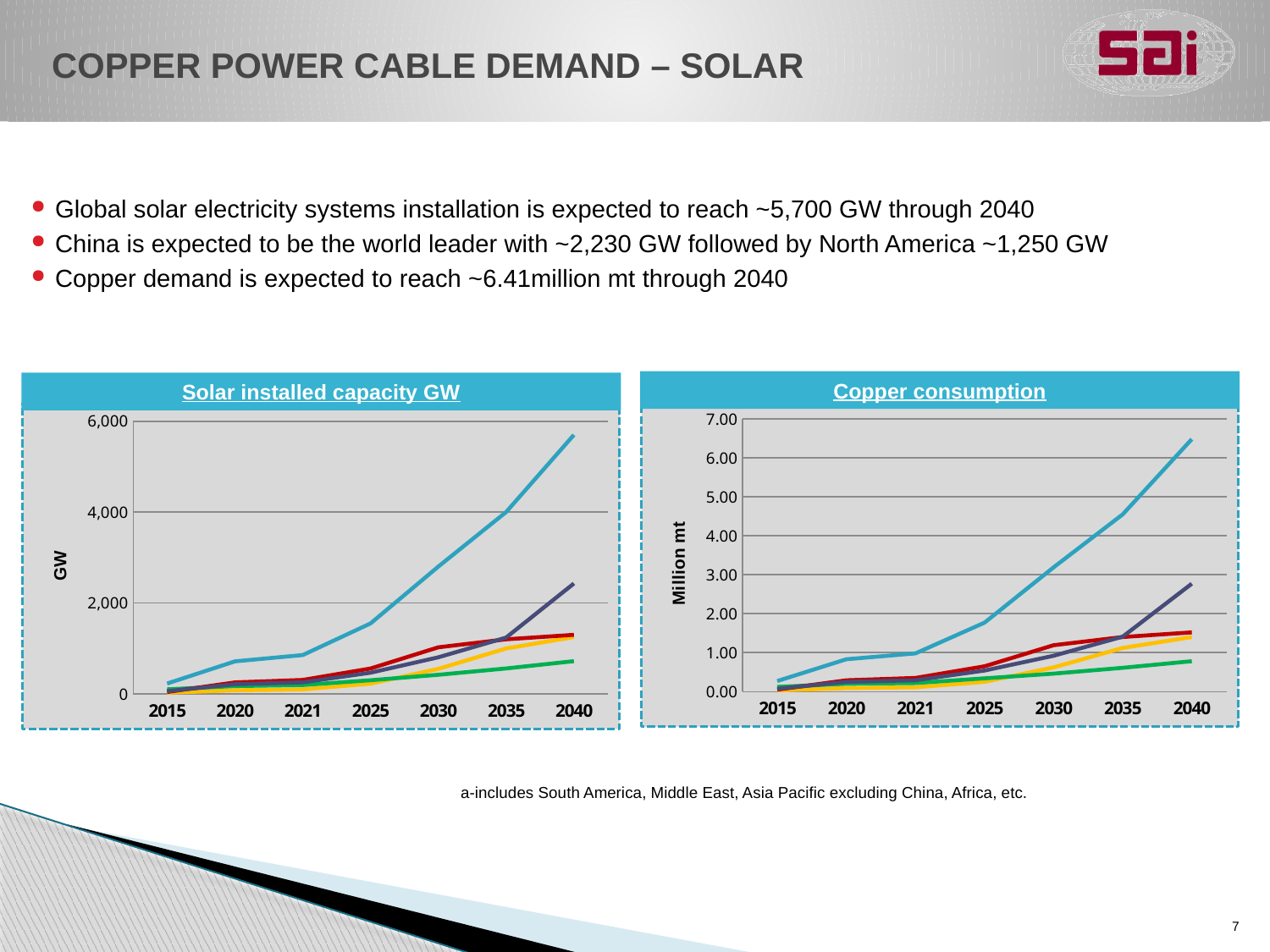
In the 'Solar installed capacity GW' chart, is the value of the highest line in 2040 greater or less than 4,000? greater What is the y-axis label of the 'Copper consumption' chart? Million mt In the 'Solar installed capacity GW' chart, does the highest line rise or fall from 2015 to 2040? rise What kind of chart is the 'Solar installed capacity GW' chart? line chart What kind of chart is the 'Copper consumption' chart? line chart In the 'Copper consumption' chart, does the highest line rise or fall from 2015 to 2040? rise In the 'Copper consumption' chart, is the value of the highest line in 2040 greater or less than 6.00? greater In the 'Solar installed capacity GW' chart, is the value of the highest line in 2025 greater or less than 2,000? less In the 'Solar installed capacity GW' chart, how many years are shown on the x axis? 7 In the 'Copper consumption' chart, how many lines are plotted? 5 What is the highest value shown on the y axis of the 'Solar installed capacity GW' chart? 6,000